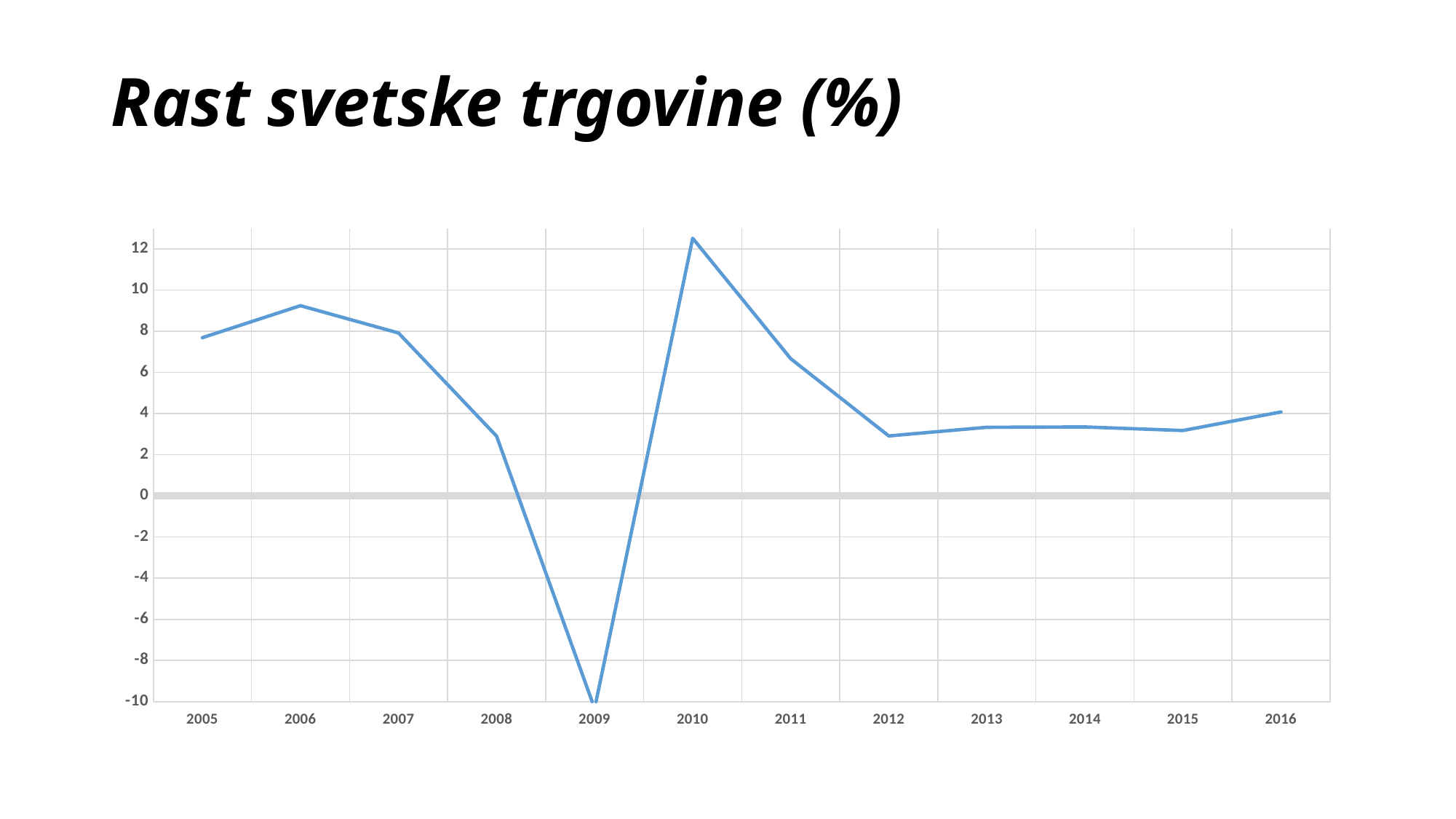
Is the value for 2010 greater or less than 10? greater Is the value for 2005 greater or less than 8? less Is the value for 2009 greater or less than -8? less What kind of chart is shown on the slide? line chart Which year has the larger value, 2008 or 2011? 2011 Which year has the larger value, 2006 or 2007? 2006 What is the title of the chart? Rast svetske trgovine (%) Do the values rise or fall from 2006 to 2009? fall Which year has the lowest value? 2009 How many years are plotted on the x axis? 12 Which year has the highest value? 2010